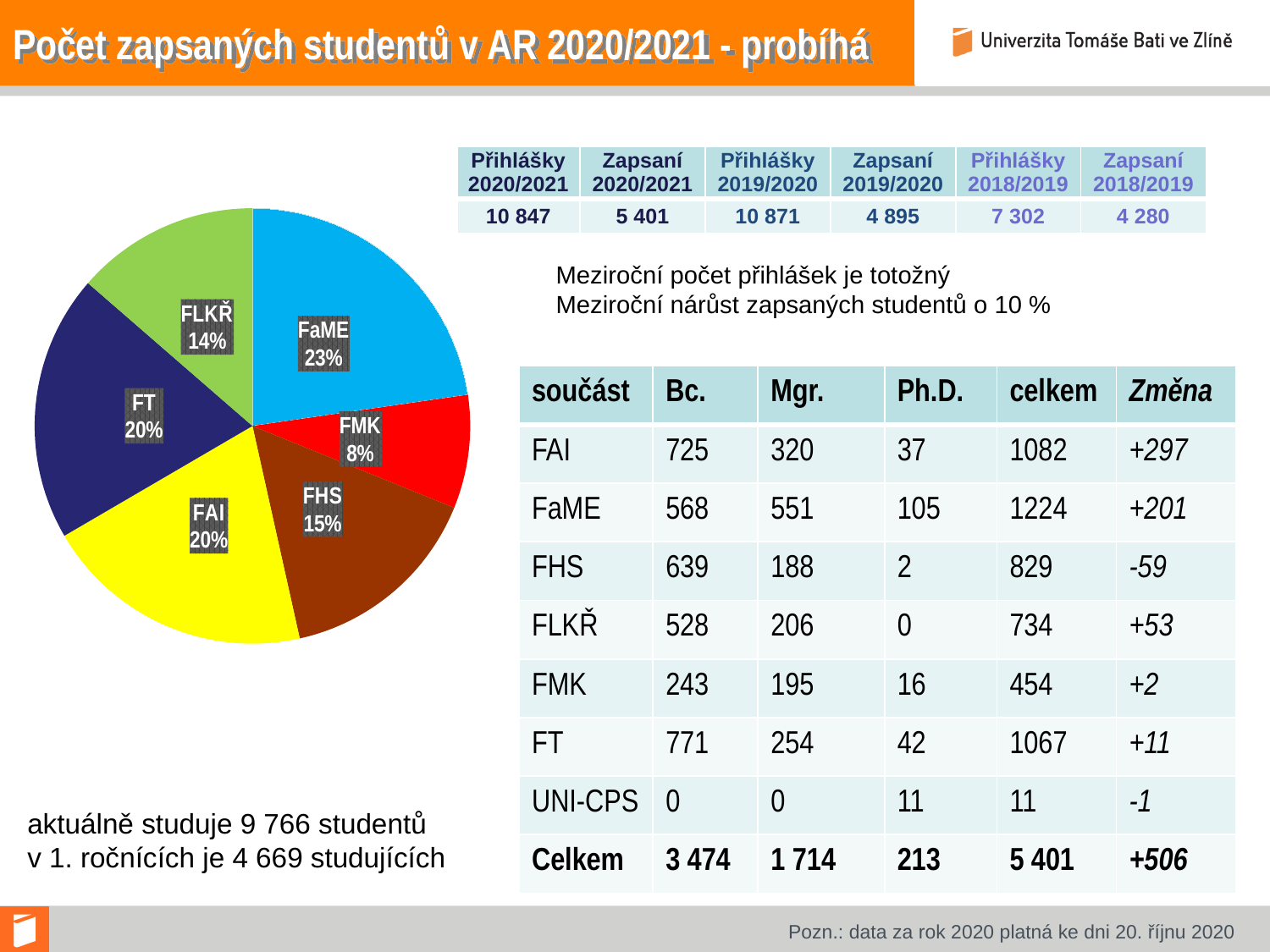
What share of the pie chart does FHS have? 15% What kind of chart is shown on the slide? pie chart In the pie chart, what is the difference in percentage points between the FT slice and the FMK slice? 12 In the pie chart, which is larger, the FHS slice or the FMK slice? FHS In the pie chart, what is the difference in percentage points between the FaME slice and the FLKŘ slice? 9 What share of the pie chart does FaME have? 23% What share of the pie chart does FLKŘ have? 14% What colour is the FAI slice in the pie chart? yellow How many slices does the pie chart have? 6 Which slice of the pie chart is the smallest? FMK What share of the pie chart does FMK have? 8% Which slice of the pie chart is the largest? FaME